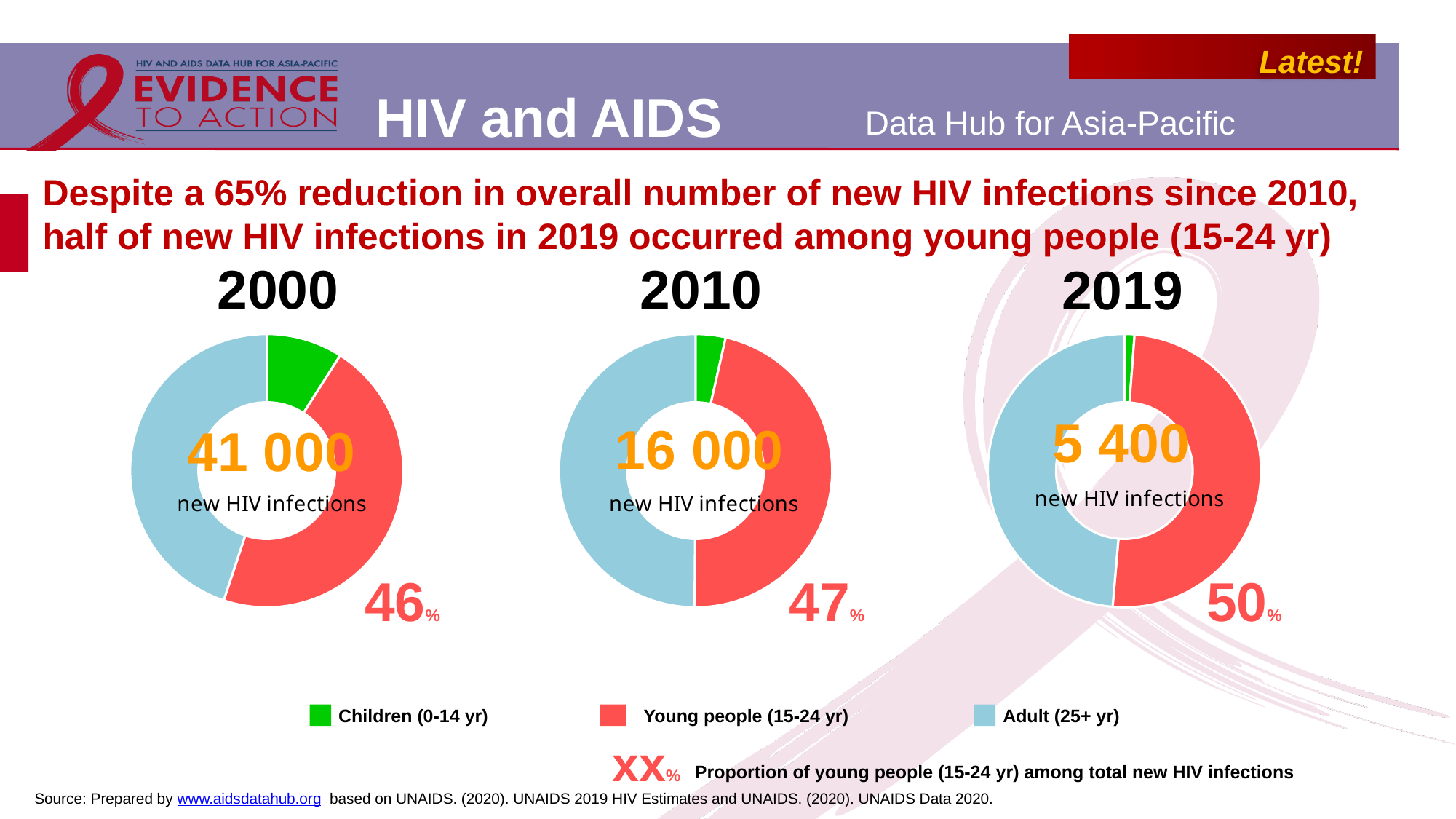
How many age groups does the legend list for the donut charts? 3 What is the difference in the number of new HIV infections between the 2000 chart and the 2010 chart? 25 000 In the 2010 chart, how many new HIV infections are shown in the centre? 16 000 In the 2019 chart, what proportion of new HIV infections occurred among young people (15-24 yr)? 50% Which year's chart shows the highest number of new HIV infections? 2000 In the 2019 chart, how many new HIV infections are shown in the centre? 5 400 Which age group is shown in green in the donut charts? Children (0-14 yr) Is the proportion of young people among new HIV infections larger in the 2010 chart or the 2019 chart? 2019 In the 2000 chart, how many new HIV infections are shown in the centre? 41 000 Which year's chart shows the lowest number of new HIV infections? 2019 What kind of charts are shown on the slide for 2000, 2010 and 2019? Donut (pie) charts In the 2000 chart, what proportion of new HIV infections occurred among young people (15-24 yr)? 46%